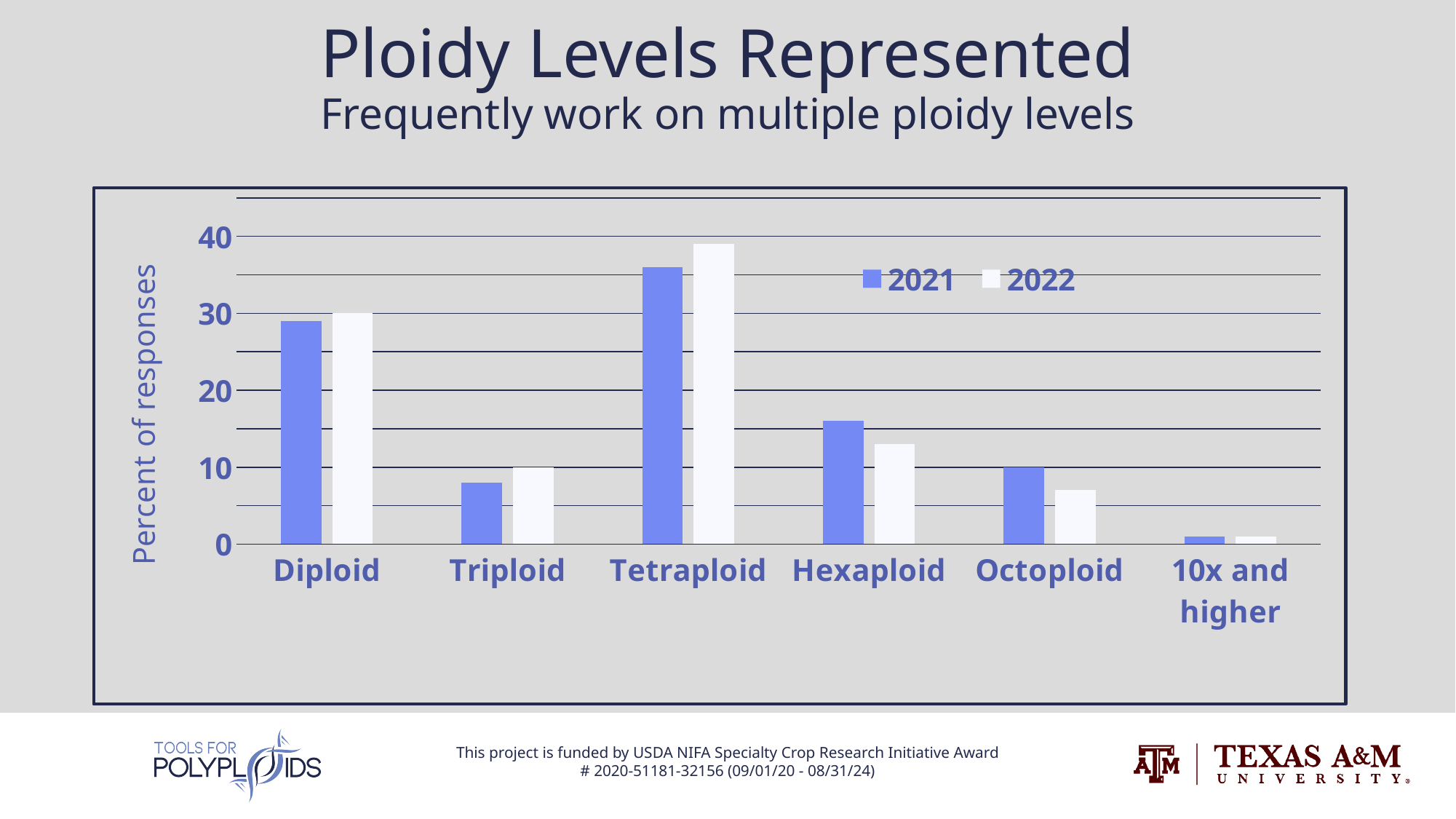
How many ploidy level categories are shown on the x axis? 6 For Hexaploid, which year has the larger percent of responses, 2021 or 2022? 2021 Which ploidy level has the lowest percent of responses for 2021? 10x and higher What is the label on the y axis of the chart? Percent of responses Is the 2021 value for Tetraploid greater or less than 30? greater How many series does the legend list? 2 Is the 2022 value for Hexaploid greater or less than 10? greater What kind of chart is shown on the slide? Bar chart Is the 2022 value for Octoploid greater or less than 10? less For Tetraploid, which year has the larger percent of responses, 2021 or 2022? 2022 Which ploidy level has the highest percent of responses for 2022? Tetraploid